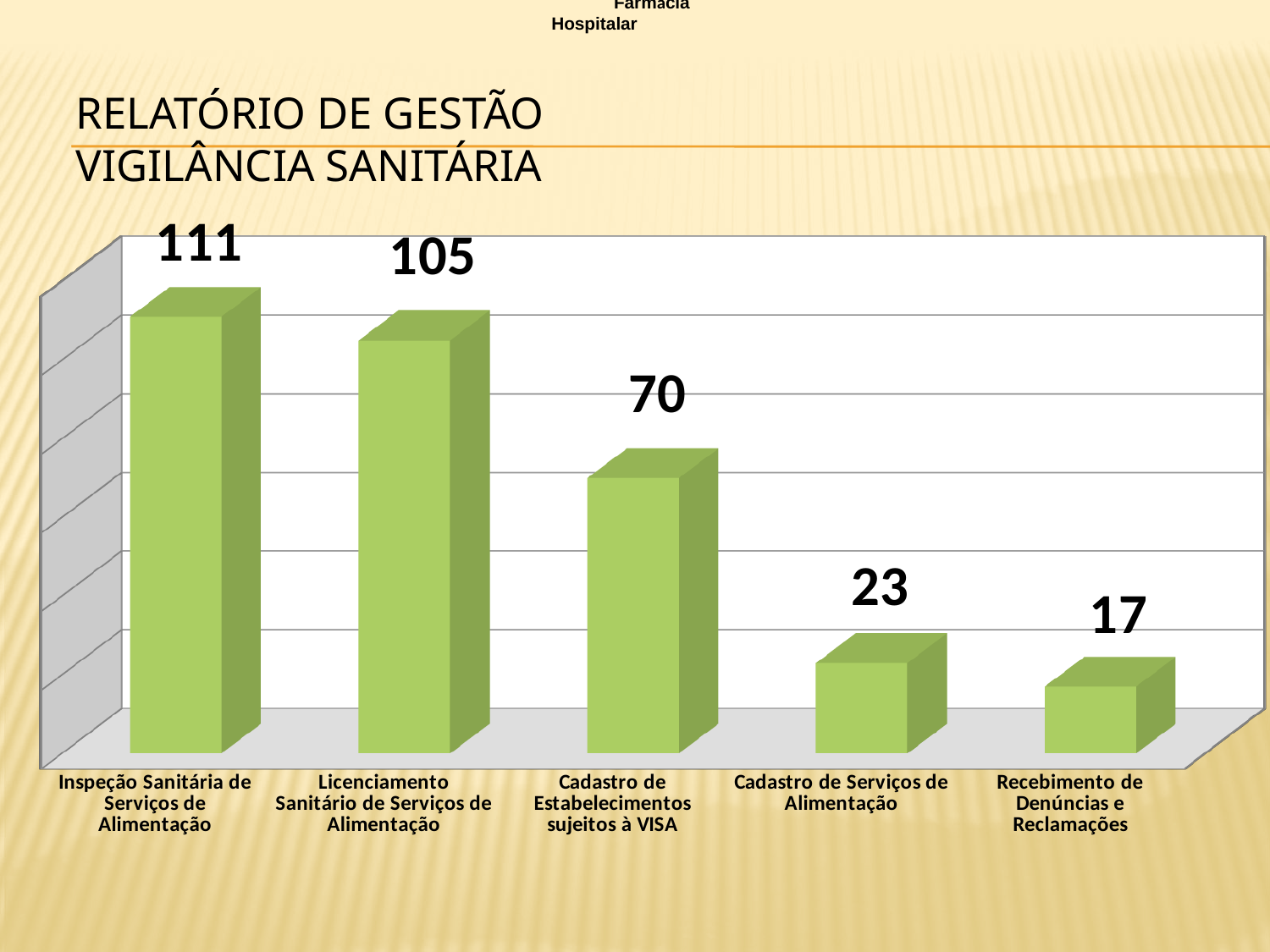
What kind of chart is shown on the slide? bar chart What is the difference between the values for Cadastro de Estabelecimentos sujeitos à VISA and Cadastro de Serviços de Alimentação? 47 What is the value for Cadastro de Estabelecimentos sujeitos à VISA? 70 How many categories are shown in the chart? 5 What is the value for Recebimento de Denúncias e Reclamações? 17 What is the value for Licenciamento Sanitário de Serviços de Alimentação? 105 Which is larger: the value for Cadastro de Serviços de Alimentação or the value for Recebimento de Denúncias e Reclamações? Cadastro de Serviços de Alimentação What is the value for Inspeção Sanitária de Serviços de Alimentação? 111 What is the difference between the values for Inspeção Sanitária de Serviços de Alimentação and Licenciamento Sanitário de Serviços de Alimentação? 6 Do the values rise or fall from left to right across the categories? fall Which category has the lowest value? Recebimento de Denúncias e Reclamações Which category has the highest value? Inspeção Sanitária de Serviços de Alimentação